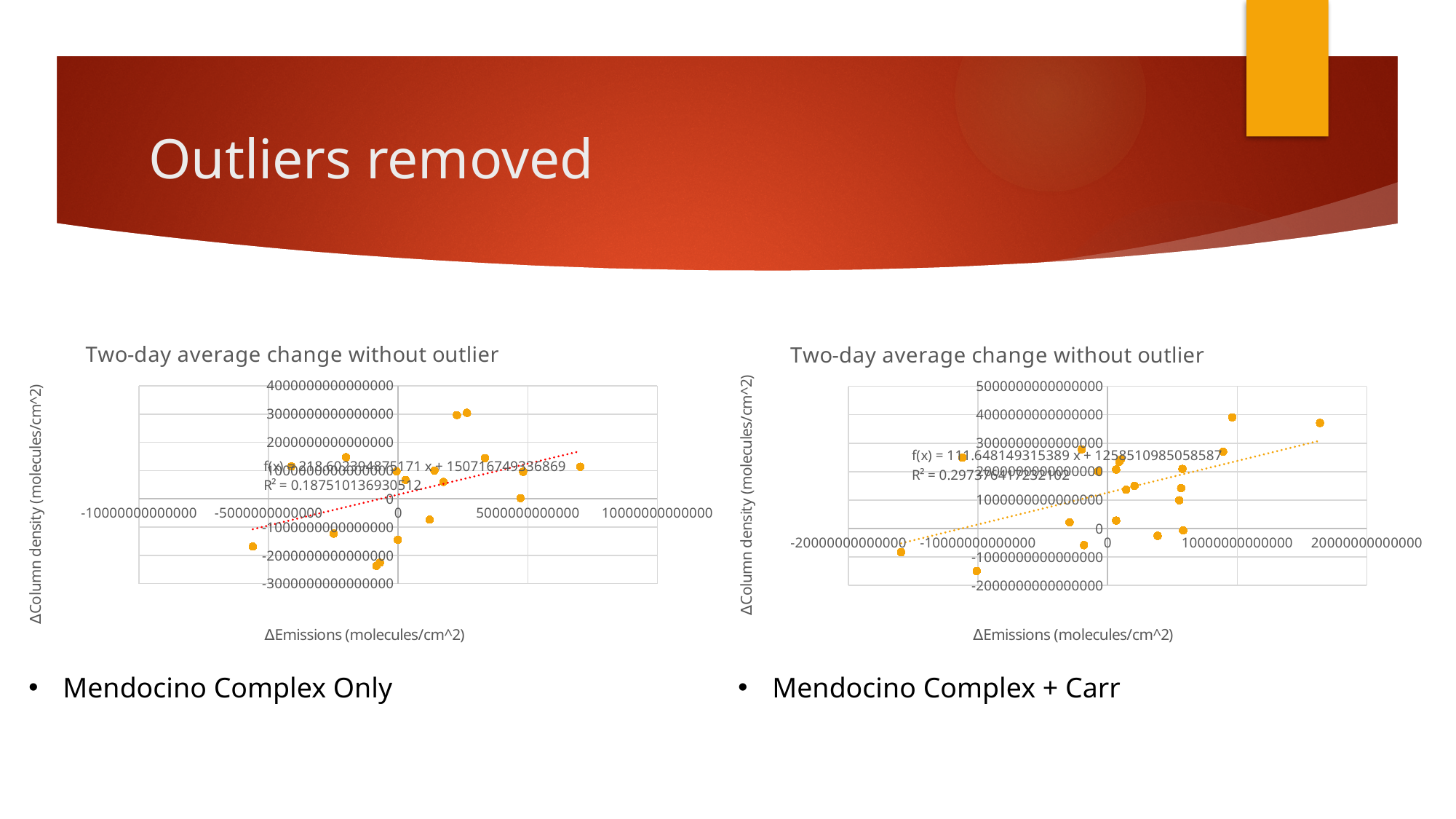
In the left chart, is the highest plotted ΔColumn density value greater or less than 2000000000000000? greater What is the x-axis label of the right chart? ΔEmissions (molecules/cm^2) What kind of chart is the left chart on the slide? scatter chart In the right chart, does the dotted trend line rise or fall as ΔEmissions increases? rise What is the title of the left chart? Two-day average change without outlier In the right chart, what is the intercept shown in the fitted trend line equation f(x)? 1258510985058587 What kind of chart is the right chart on the slide? scatter chart In the right chart, what is the slope coefficient shown in the fitted trend line equation f(x)? 111.648149315389 In the right chart, is the highest plotted ΔColumn density value greater or less than 3000000000000000? greater In the left chart, is the lowest plotted ΔColumn density value greater or less than -2000000000000000? less In the left chart, does the dotted trend line rise or fall as ΔEmissions increases? rise